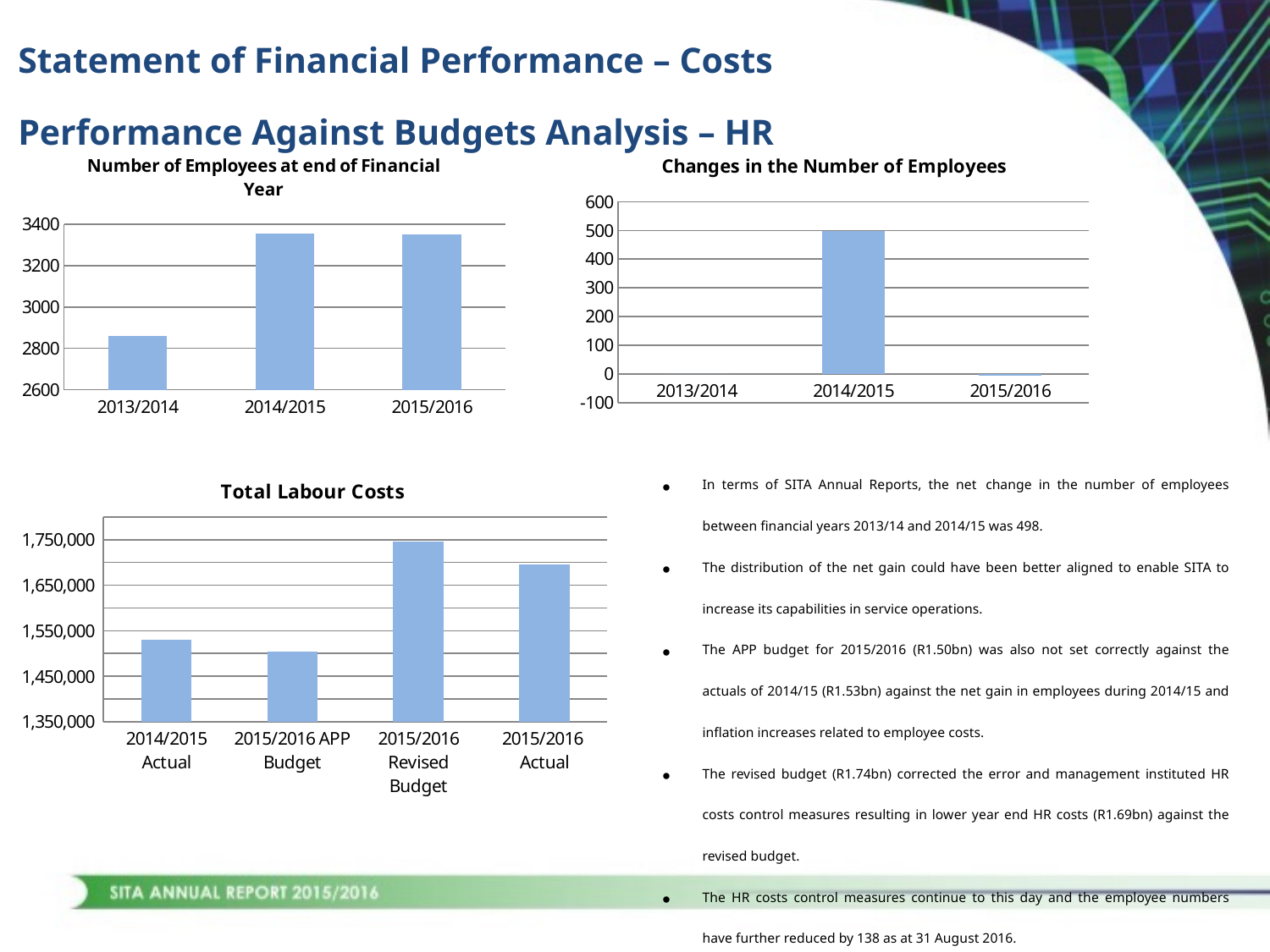
How many categories are shown in the 'Total Labour Costs' chart? 4 In the 'Number of Employees at end of Financial Year' chart, is the value for 2014/2015 greater or less than 3200? greater In the 'Number of Employees at end of Financial Year' chart, which financial year has the lowest number of employees? 2013/2014 In the 'Total Labour Costs' chart, is the value for 2015/2016 Actual greater or less than 1,650,000? greater In the 'Total Labour Costs' chart, is the value for 2015/2016 APP Budget greater or less than 1,550,000? less In the 'Total Labour Costs' chart, which is larger: 2015/2016 Revised Budget or 2015/2016 Actual? 2015/2016 Revised Budget In the 'Number of Employees at end of Financial Year' chart, how many financial years are shown? 3 In the 'Total Labour Costs' chart, which category has the highest value? 2015/2016 Revised Budget What kind of chart is the 'Changes in the Number of Employees' chart? Bar chart In the 'Changes in the Number of Employees' chart, which financial year has the highest change? 2014/2015